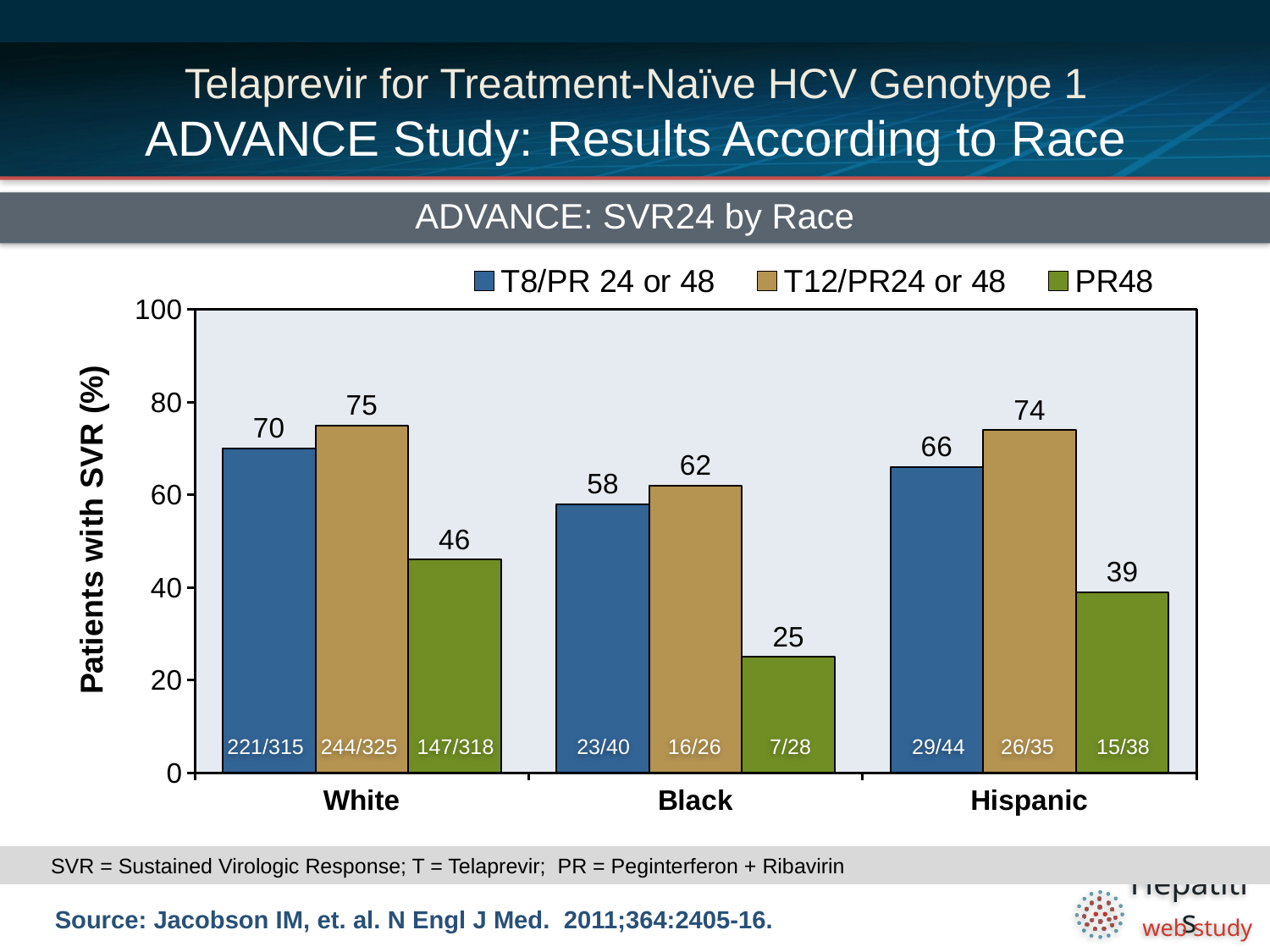
What is the label of the y axis? Patients with SVR (%) How many race categories are shown on the x axis? 3 Which race category has the lowest SVR rate for the T12/PR24 or 48 group? Black What is the SVR rate for the PR48 group among Black patients? 25 What is the SVR rate for the T12/PR24 or 48 group among Hispanic patients? 74 What is the SVR rate for the T8/PR 24 or 48 group among White patients? 70 Which is larger among Hispanic patients: the SVR rate for T8/PR 24 or 48 or for PR48? T8/PR 24 or 48 What is the difference between the T12/PR24 or 48 and PR48 SVR rates among Black patients? 37 What is the chart's title? ADVANCE: SVR24 by Race How many series does the legend list? 3 What kind of chart is shown on the slide? Bar chart Which race category has the highest SVR rate for the PR48 group? White